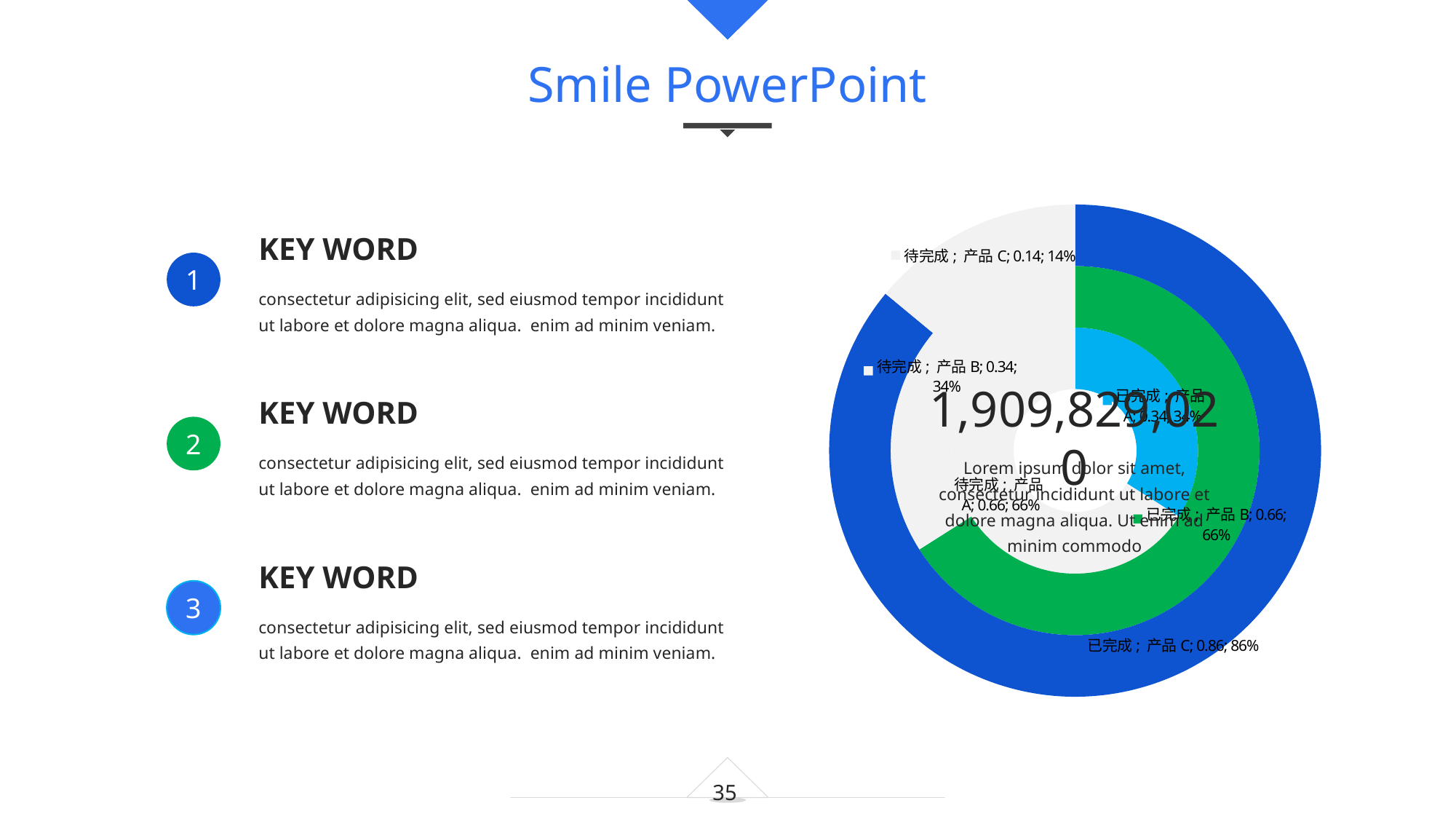
What kind of chart is shown on the right of the slide? doughnut chart Which product has the highest 已完成 (completed) share in the doughnut chart? 产品 C What is the 待完成 (pending) share for 产品 C in the doughnut chart? 14% How many products (rings) are shown in the doughnut chart? 3 What is the difference between the 已完成 share and the 待完成 share for 产品 C? 72% For 产品 B, which is larger: the 已完成 share or the 待完成 share? 已完成 What is the 已完成 (completed) share for 产品 B in the doughnut chart? 66% What is the difference between the 已完成 share and the 待完成 share for 产品 B? 32% What large number is printed in the centre of the doughnut chart? 1,909,829,020 What is the 待完成 (pending) share for 产品 B in the doughnut chart? 34% What is the 已完成 (completed) share for 产品 C in the doughnut chart? 86% What is the title of the slide containing the doughnut chart? Smile PowerPoint